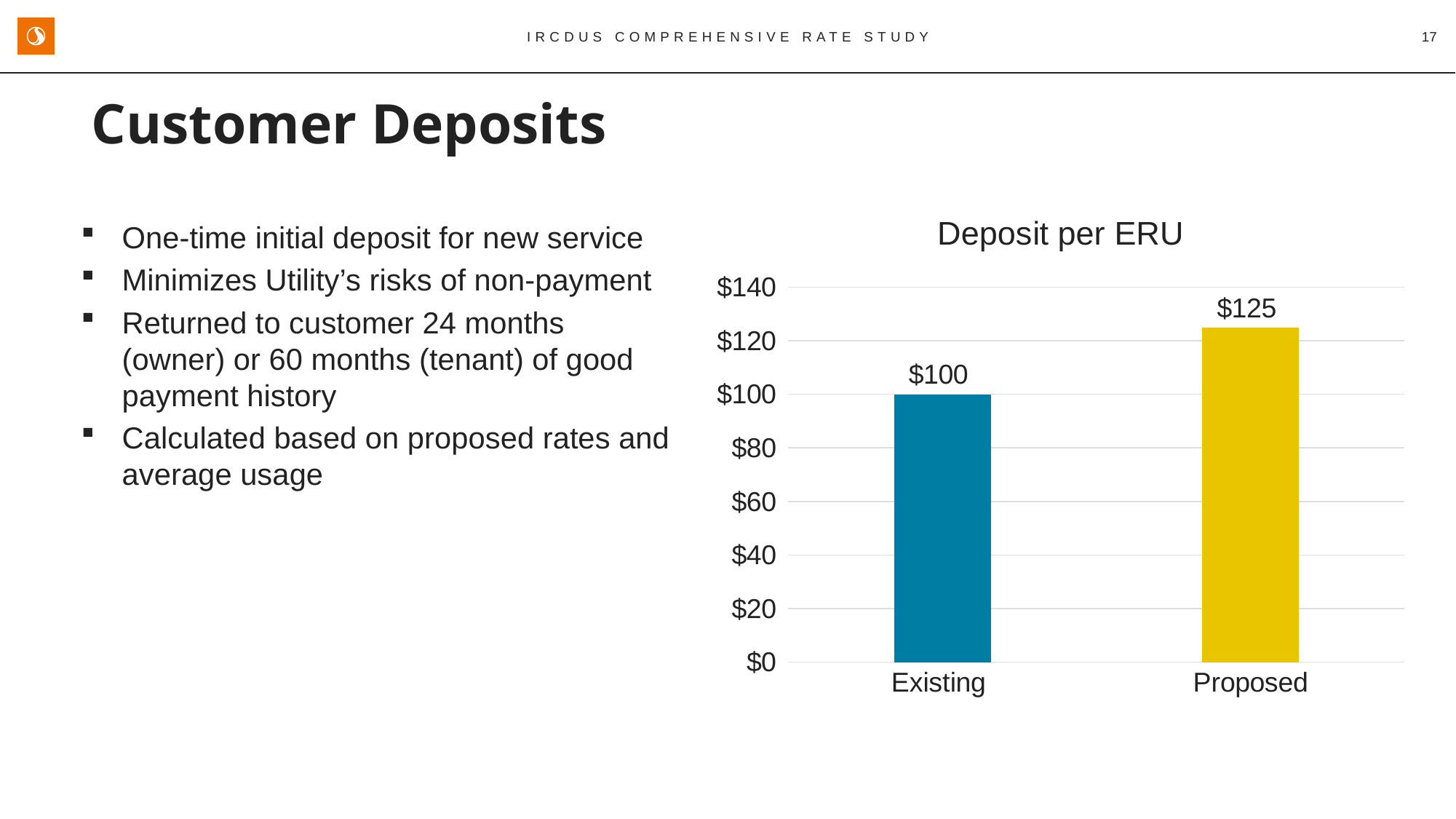
How many categories are shown in the chart? 2 What is the difference between the Proposed and Existing deposit per ERU? $25 What kind of chart is shown on the slide? bar chart Is the value for Existing greater or less than $120? less Which category has the lower deposit per ERU? Existing Is the deposit per ERU larger for Existing or Proposed? Proposed Which category has the higher deposit per ERU? Proposed What colour is the bar for Proposed? yellow What is the deposit per ERU for Proposed? $125 Is the value for Proposed greater or less than $120? greater What is the deposit per ERU for Existing? $100 What is the title of the chart? Deposit per ERU